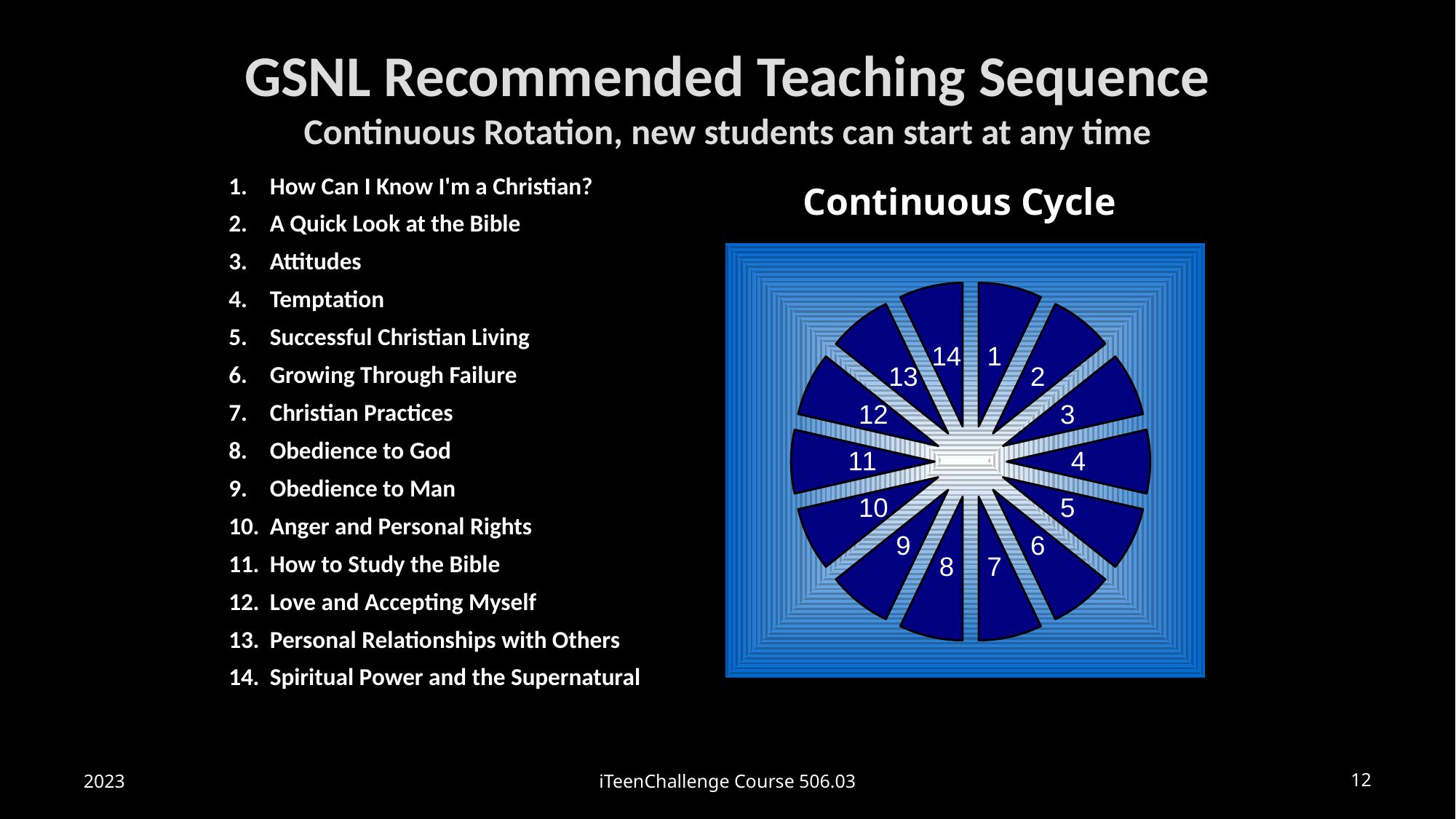
Does the "Continuous Cycle" pie chart have a legend? No What is the title printed above the pie chart? Continuous Cycle What is the highest number labelled on a slice of the "Continuous Cycle" pie chart? 14 How many slices does the "Continuous Cycle" pie chart have? 14 What kind of chart is shown under the heading "Continuous Cycle"? pie chart Which slice number sits immediately counter-clockwise before slice 1 in the "Continuous Cycle" pie chart? 14 Are the slices of the "Continuous Cycle" pie chart all the same size or different sizes? the same size